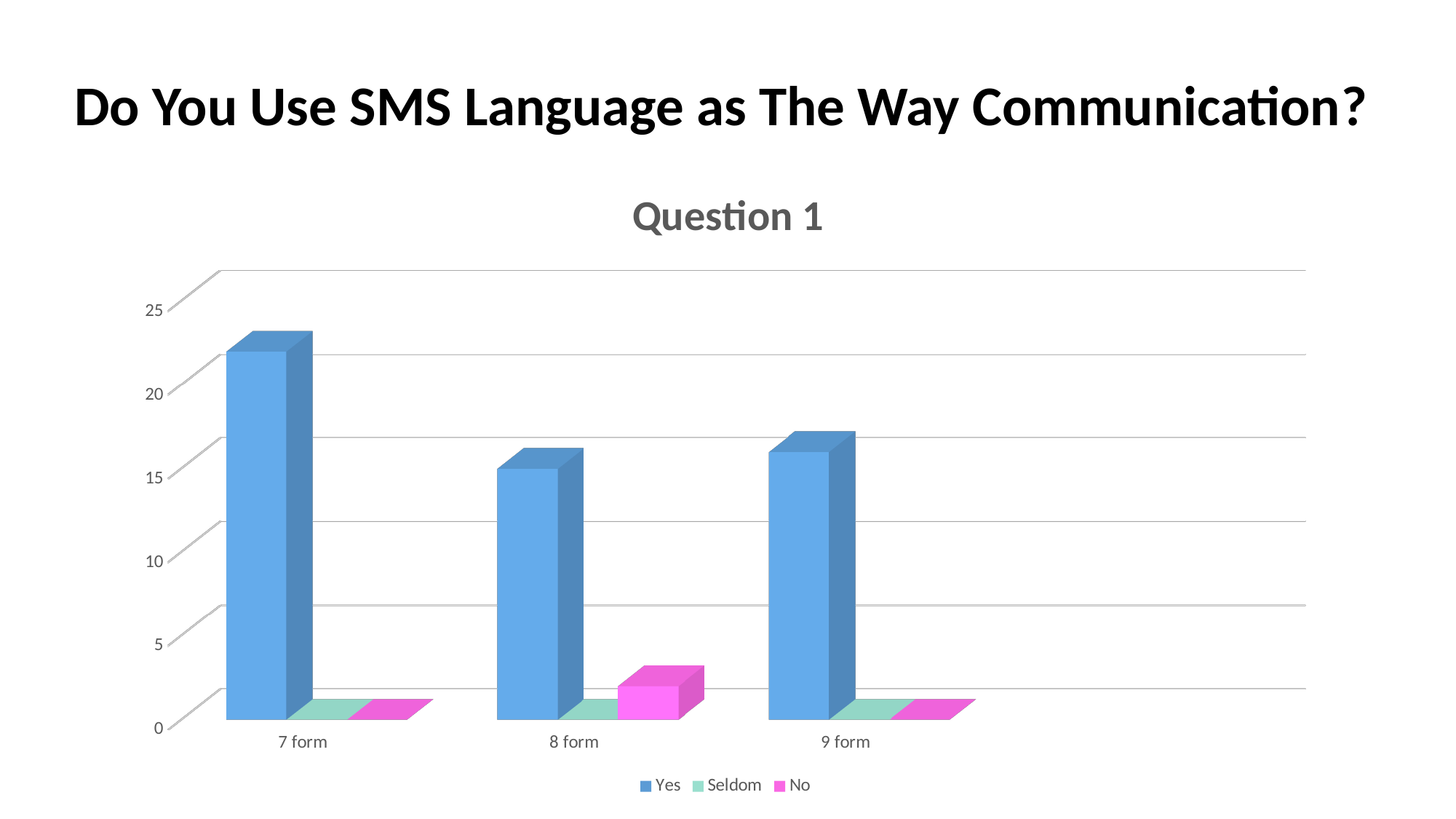
How many categories are shown on the x axis? 3 Which category has the highest value for the No series? 8 form What is the title of the chart? Question 1 Is the No value for 8 form greater or less than 5? less Which series is shown in blue in the legend? Yes Is the Yes value for 9 form greater or less than 10? greater Is the Yes value for 7 form greater or less than 15? greater What kind of chart is shown on the slide? bar chart Which is larger, the Yes value for 7 form or the Yes value for 8 form? 7 form How many series does the legend list? 3 Which category has the highest value for the Yes series? 7 form